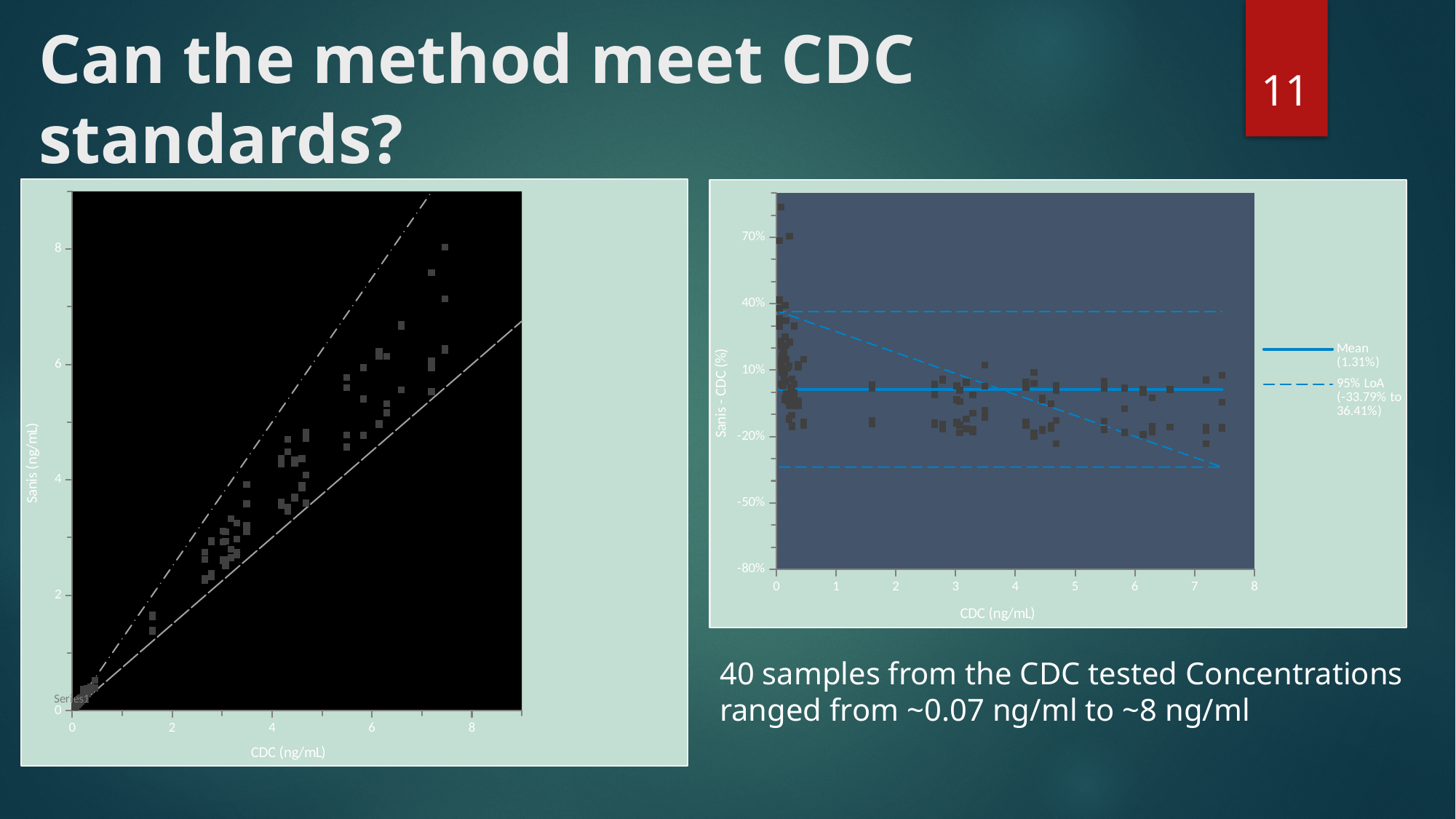
In the chart on the right, which is larger: the mean value or the upper 95% LoA value? the upper 95% LoA value What is the label of the x axis of the chart on the left? CDC (ng/mL) What kind of chart is the chart on the left of the slide? scatter chart In the chart on the right, is the mean line greater or less than 10%? less In the chart on the right, is the lower 95% LoA line greater or less than -20%? less In the chart on the right, what range is given for the 95% LoA in the legend? -33.79% to 36.41% In the chart on the right, is the upper 95% LoA line greater or less than 10%? greater What kind of chart is the chart on the right of the slide? scatter chart What is the label of the y axis of the chart on the right? Sanis - CDC (%) In the chart on the left, do the Sanis values generally rise or fall as the CDC concentration increases along the x axis? rise In the chart on the right, what mean value is given in the legend? 1.31% How many entries does the legend of the chart on the right list? 2